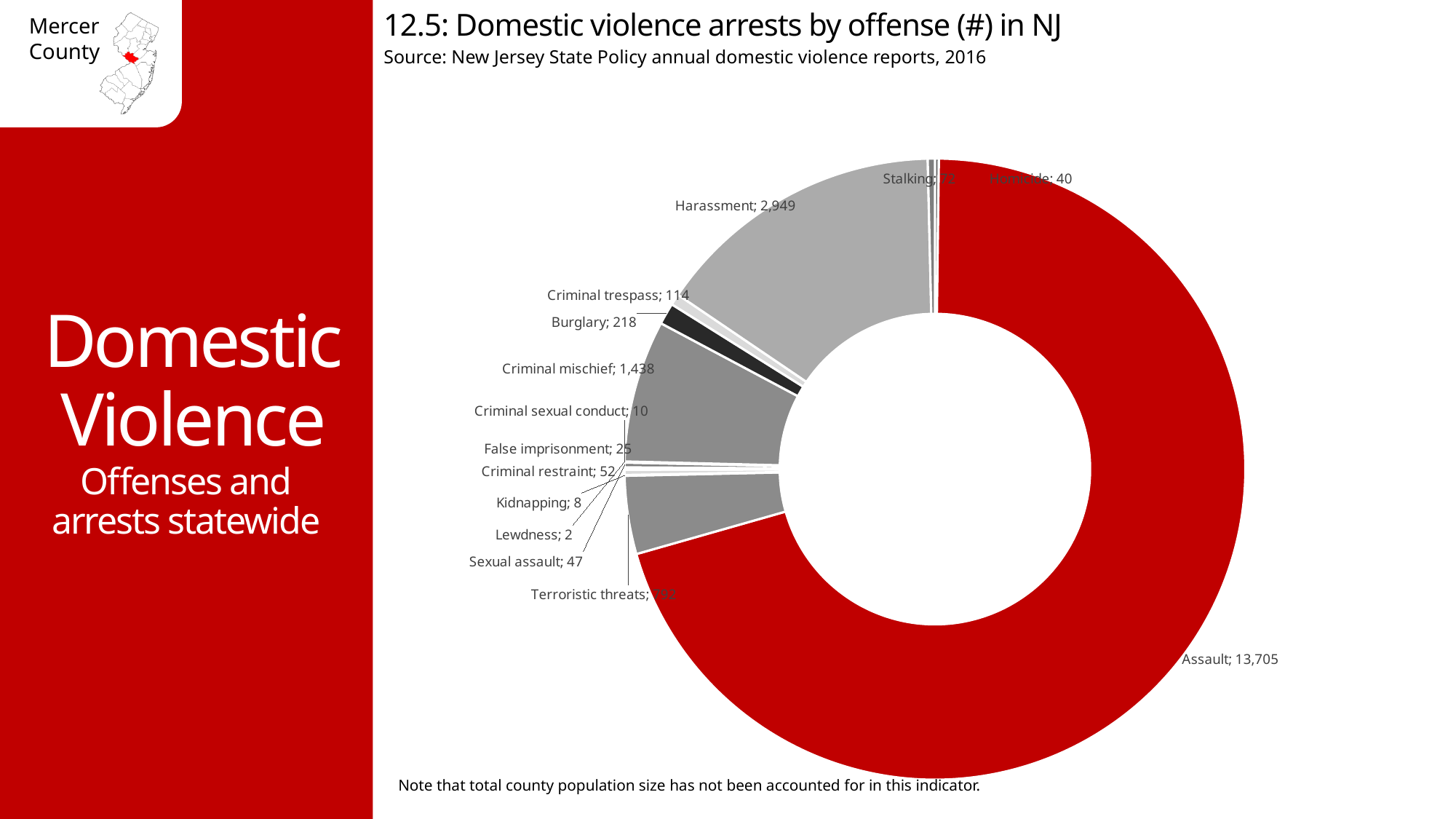
What kind of chart is shown on the slide? Pie (donut) chart What is the value shown for Criminal mischief? 1,438 What colour is the Assault slice of the chart? Red How many arrests are shown for Burglary? 218 What is the number of arrests for Harassment? 2,949 Which offense has the highest number of arrests? Assault What is the difference between the arrests for Burglary and Criminal trespass? 104 Which offense has the lowest number of arrests? Lewdness Which has more arrests, Harassment or Criminal mischief? Harassment How many offense categories are shown in the chart? 14 How many domestic violence arrests for Assault are shown? 13,705 What is the value for Homicide? 40